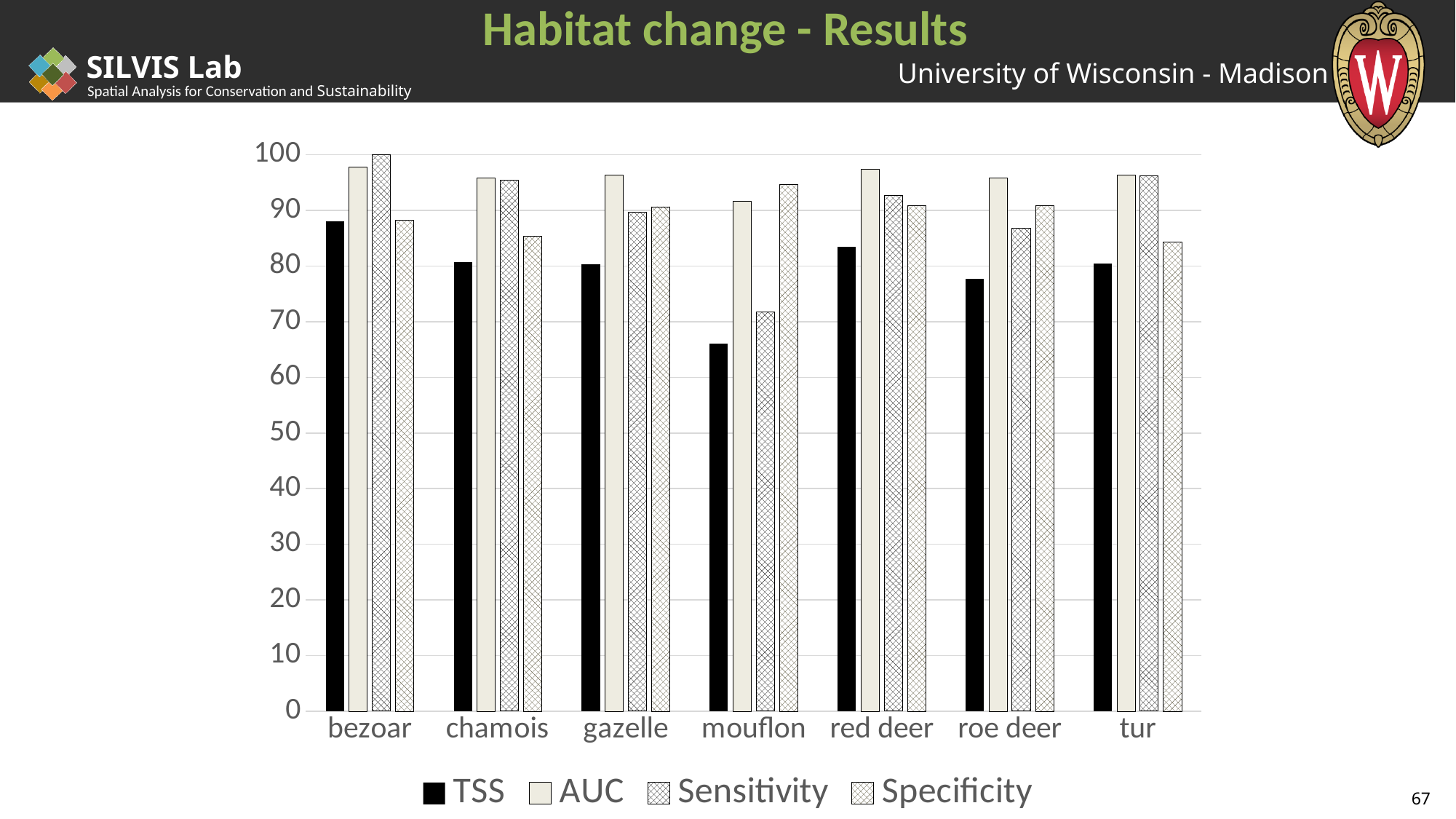
Is the Specificity value for tur greater or less than 90? less Which species has the lowest TSS value? mouflon For mouflon, which is larger: the AUC value or the Sensitivity value? AUC Which species has the lowest Sensitivity value? mouflon Is the TSS value for mouflon greater or less than 70? less Which species has the highest TSS value? bezoar How many series does the legend list? 4 Is the TSS value for bezoar greater or less than 80? greater What kind of chart is shown on the slide? bar chart Which series is drawn with solid black bars? TSS How many species categories are shown on the x axis? 7 Which species has the highest Sensitivity value? bezoar